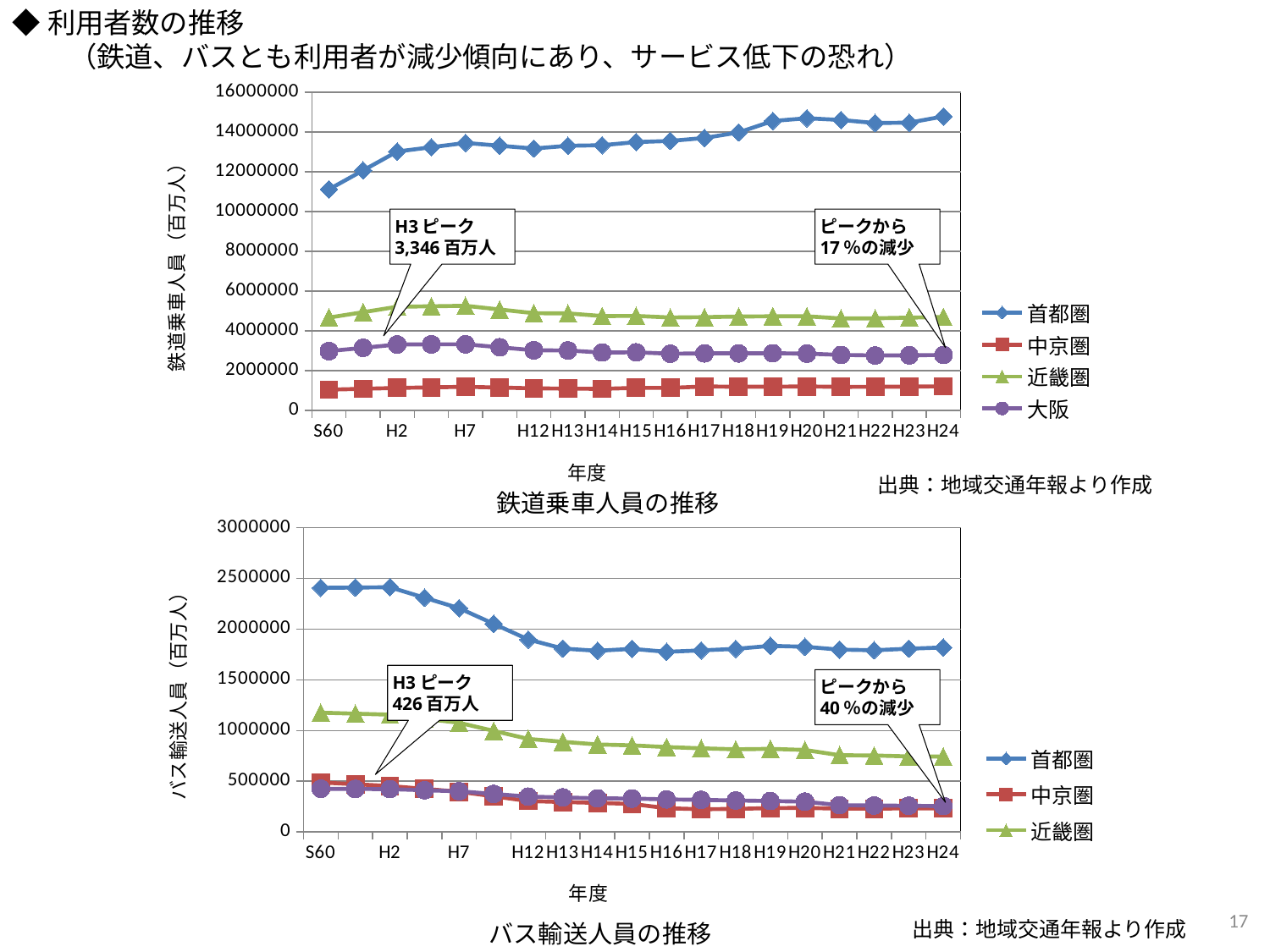
In the top chart (鉄道乗車人員の推移), which series has the lowest values? 中京圏 In the top chart (鉄道乗車人員の推移), which is larger at H24, 近畿圏 or 大阪? 近畿圏 In the bottom chart (バス輸送人員の推移), does the 首都圏 series rise or fall from S60 to H24? fall According to the annotation on the top chart (鉄道乗車人員の推移), what was the H3 peak value? 3,346 百万人 In the bottom chart (バス輸送人員の推移), is the value for 近畿圏 at H24 greater or less than 1000000? less How many series does the legend of the bottom chart (バス輸送人員の推移) list? 3 How many series does the legend of the top chart (鉄道乗車人員の推移) list? 4 According to the annotation on the bottom chart (バス輸送人員の推移), by what percentage has the value declined from the peak? 40% In the top chart (鉄道乗車人員の推移), which series has the highest values? 首都圏 In the bottom chart (バス輸送人員の推移), which series has the highest values? 首都圏 What kind of chart is the top chart titled 鉄道乗車人員の推移? line chart In the top chart (鉄道乗車人員の推移), is the value for 首都圏 at H24 greater or less than 14000000? greater